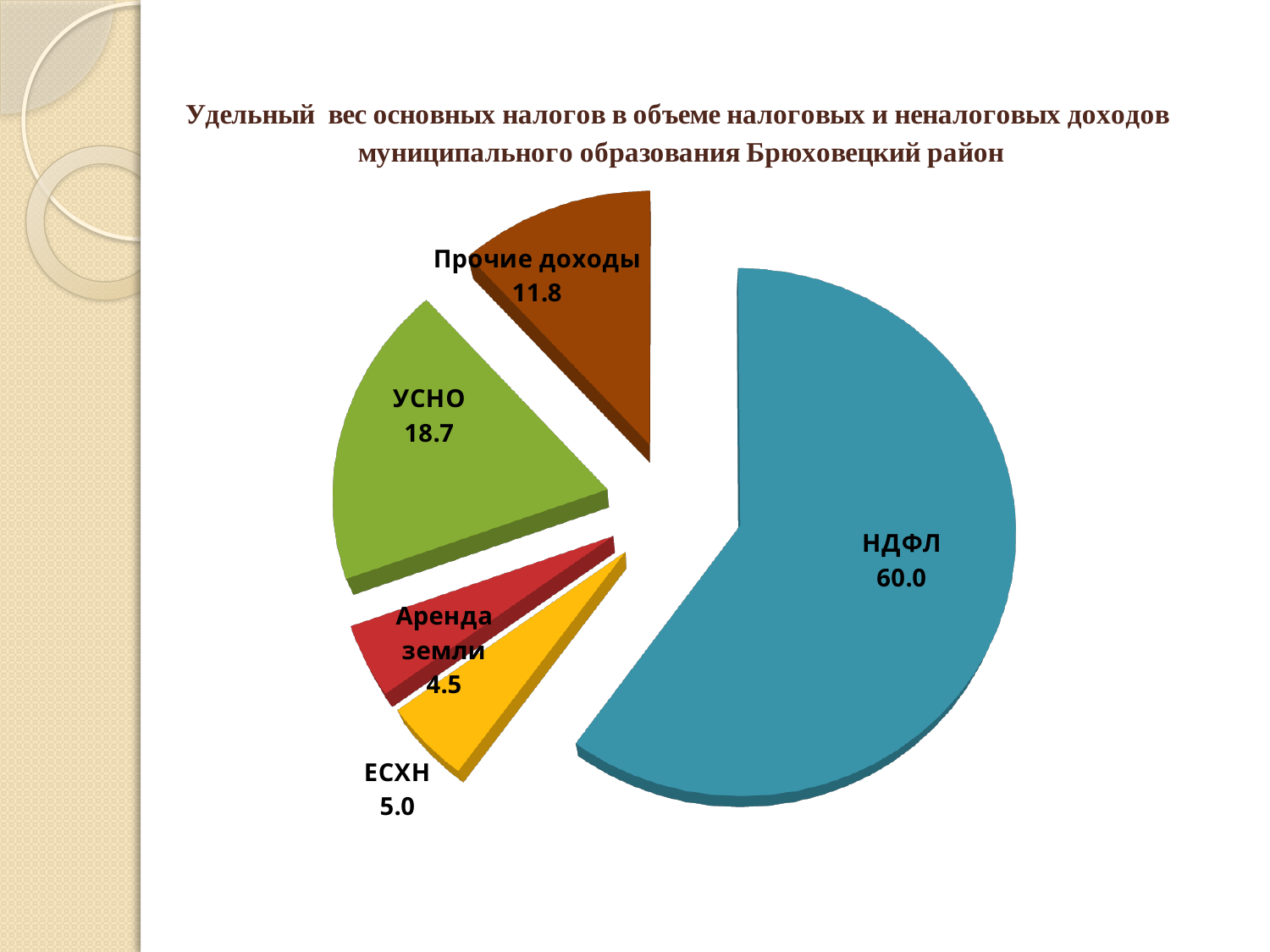
What type of chart is shown on the slide? pie chart Which category has the largest slice of the pie? НДФЛ What is the value shown for УСНО? 18.7 What is the value shown for НДФЛ? 60.0 What is the value shown for Аренда земли? 4.5 What colour is the slice for НДФЛ? blue What is the difference between the values for НДФЛ and УСНО? 41.3 How many slices does the pie chart have? 5 What is the value shown for Прочие доходы? 11.8 What is the difference between the values for УСНО and Прочие доходы? 6.9 Which is larger, the value for ЕСХН or the value for Аренда земли? ЕСХН Which category has the smallest slice of the pie? Аренда земли